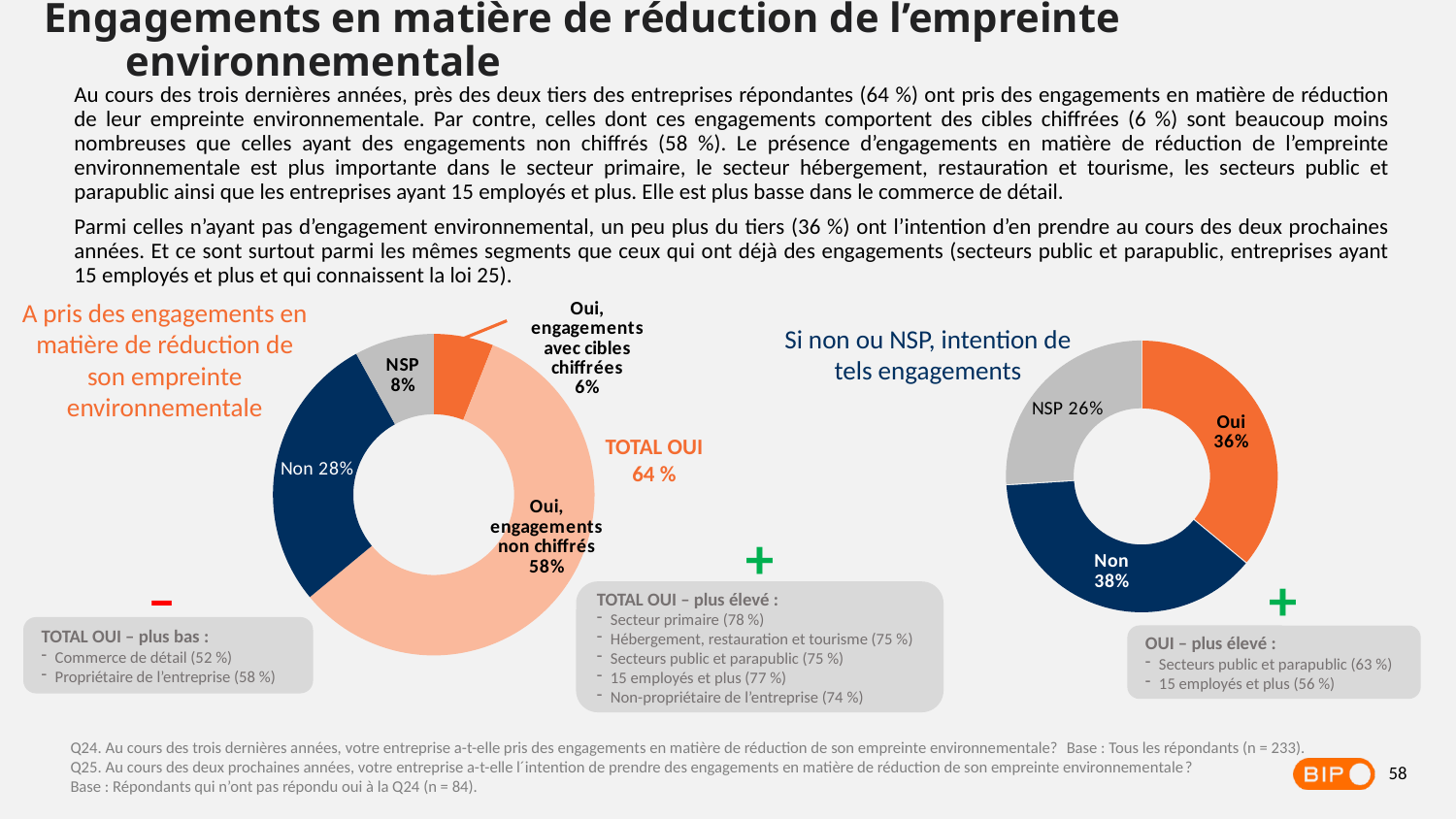
In the right chart, which is larger, "Non" or "NSP"? Non What type of chart is used on this slide? Donut (pie) chart What is the TOTAL OUI value shown next to the left chart? 64 % In the left chart, what is the difference in percentage points between "Non" and "NSP"? 20 In the left chart, what percentage corresponds to "Oui, engagements avec cibles chiffrées"? 6% In the left chart (A pris des engagements en matière de réduction de son empreinte environnementale), what share of respondents answered "Non"? 28% In the right chart (Si non ou NSP, intention de tels engagements), what share answered "Oui"? 36% In the right chart, what share answered "NSP"? 26% How many slices does the right chart have? 3 In the left chart, which category has the largest share? Oui, engagements non chiffrés In the left chart, which category has the smallest share? Oui, engagements avec cibles chiffrées In the left chart, what percentage corresponds to "Oui, engagements non chiffrés"? 58%